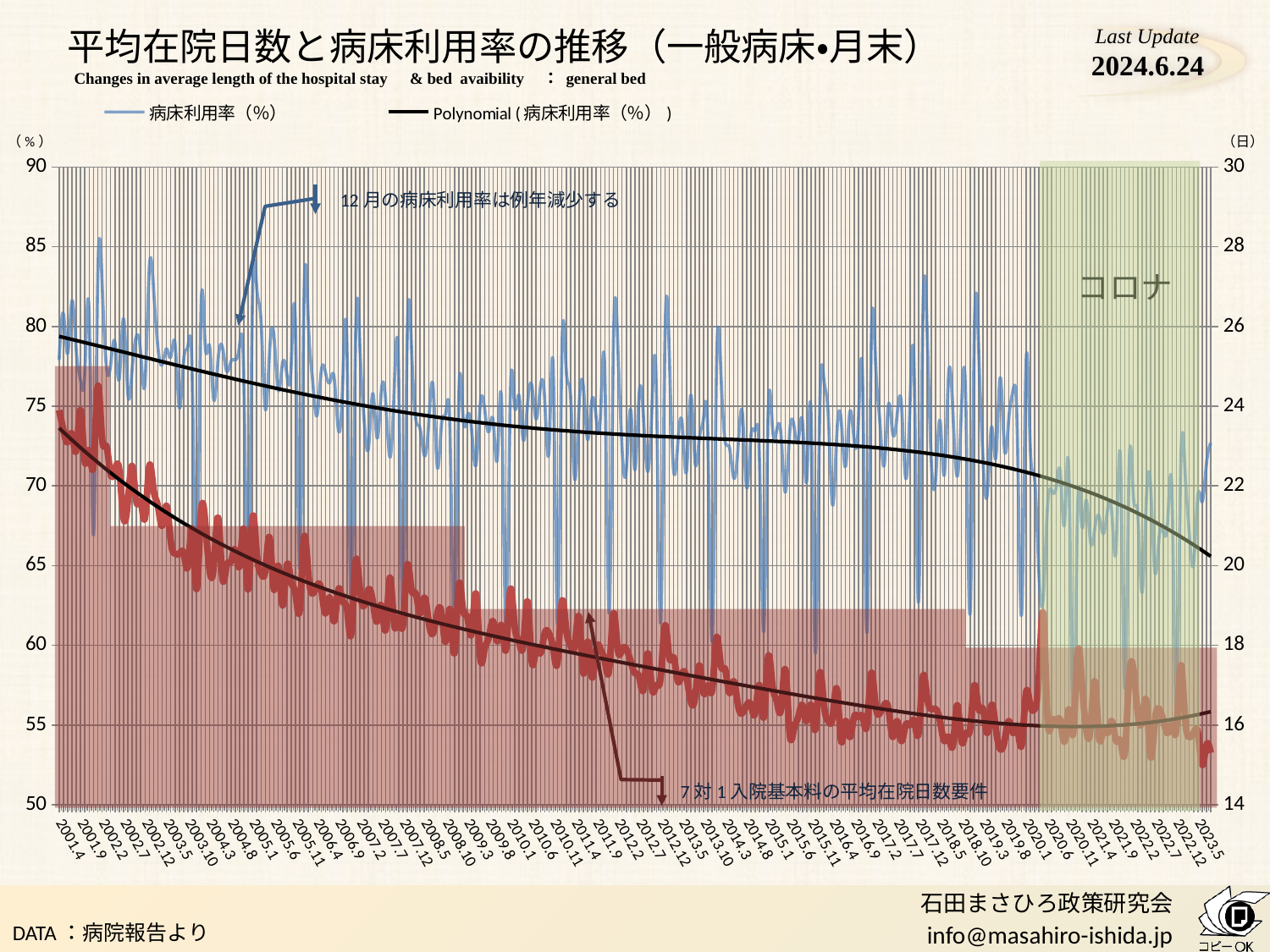
Which is higher for 病床利用率（%）: the value at 2001.4 or the value at 2023.5? 2001.4 What kind of chart is shown on the slide? line chart On the right axis (日), is the red average-length-of-stay line at 2001.4 greater or less than 22? greater What label is written in the green shaded region at the right of the chart? コロナ Does the black polynomial trend line for 病床利用率（%） rise or fall from 2001.4 to 2023.5? fall On the right axis (日), is the red average-length-of-stay line at 2023.5 greater or less than 18? less Is the value of the polynomial trend line for 病床利用率（%） at 2023.5 greater or less than 70? less How many series does the legend list? 2 What unit is shown on the left vertical axis and what unit on the right vertical axis? (%) on the left, (日) on the right Does the red line for average length of hospital stay rise or fall overall from 2001.4 to 2023.5? fall